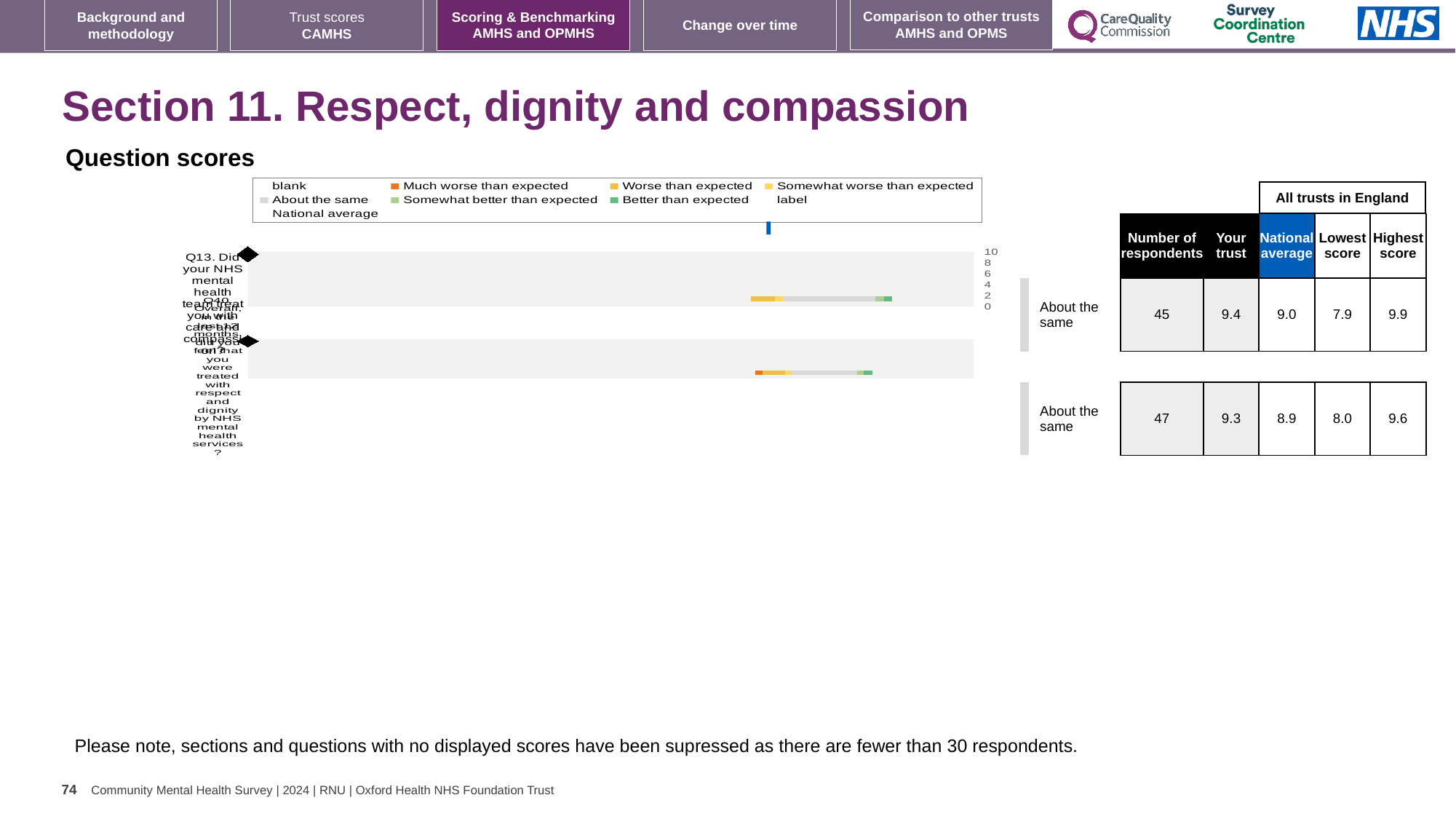
Which question has the higher 'Your trust' score, Q13 or Q10? Q13 What is the 'Your trust' score for the top question (Q13) in the question scores chart? 9.4 What is the title of the chart on this slide? Question scores What type of chart is used to show the question scores on this slide? bar chart How is the trust's result for Q13 categorised relative to other trusts in the question scores chart? About the same How many respondents are shown for Q10 in the question scores chart? 47 How many questions (bars) are plotted in the question scores chart? 2 What is the difference between the highest and lowest scores across all trusts for Q10? 1.6 What is the national average score for Q13 in the question scores chart? 9.0 How many entries does the legend of the question scores chart list? 9 What is the 'Your trust' score for the bottom question (Q10) in the question scores chart? 9.3 What is the highest score across all trusts in England for Q13? 9.9